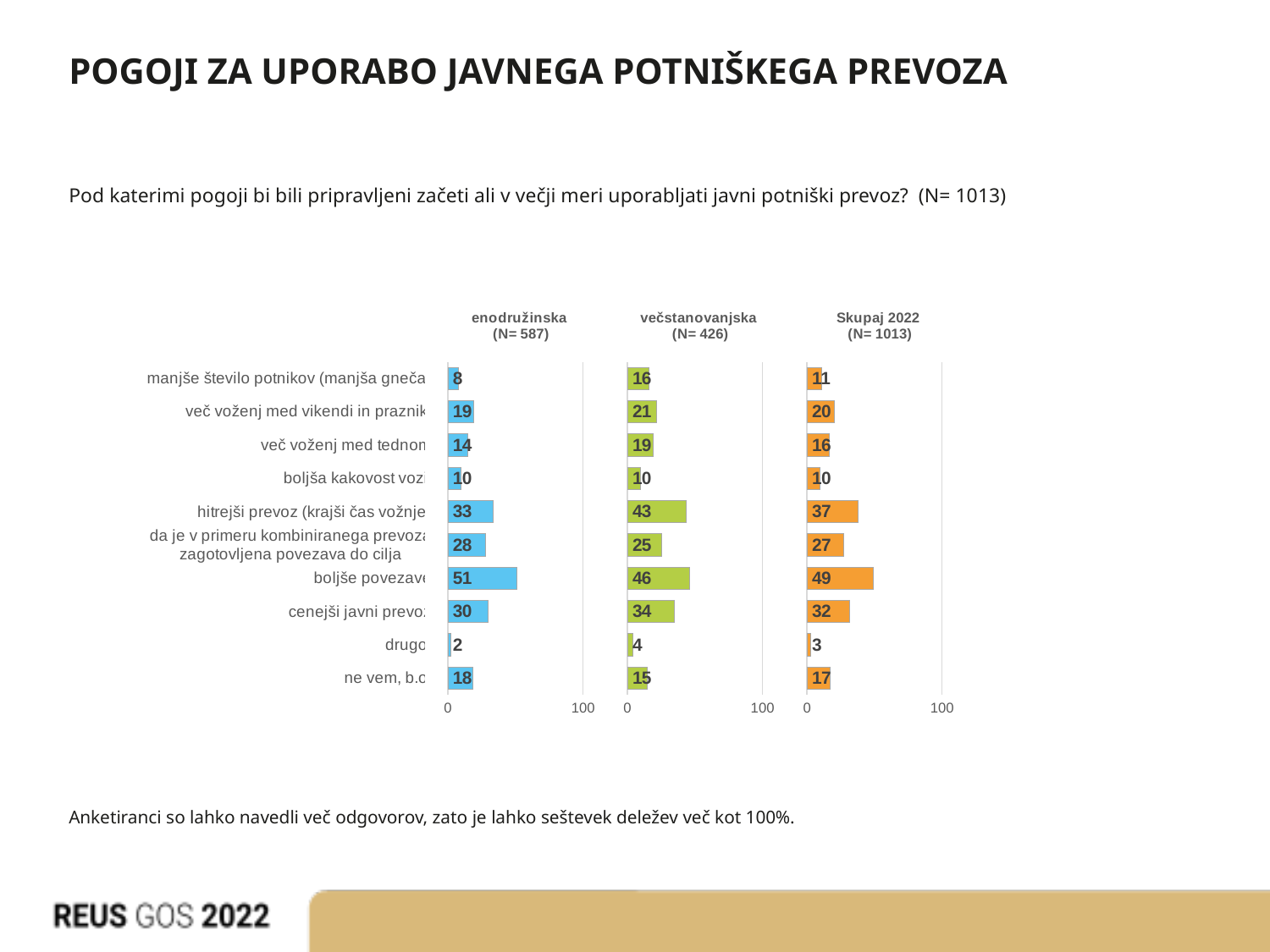
Which is larger: 'hitrejši prevoz (krajši čas vožnje)' in the 'enodružinska (N= 587)' chart or in the 'večstanovanjska (N= 426)' chart? večstanovanjska (N= 426) In the 'večstanovanjska (N= 426)' chart, what is the difference between 'boljše povezave' and 'hitrejši prevoz (krajši čas vožnje)'? 3 What colour are the bars in the 'Skupaj 2022 (N= 1013)' chart? orange In the 'enodružinska (N= 587)' chart, is the value for 'boljše povezave' greater or less than 100? less In the 'Skupaj 2022 (N= 1013)' chart, what is the value for 'hitrejši prevoz (krajši čas vožnje)'? 37 How many categories are shown in the 'Skupaj 2022 (N= 1013)' chart? 10 In the 'enodružinska (N= 587)' chart, what is the value for 'cenejši javni prevoz'? 30 What kind of chart is the 'večstanovanjska (N= 426)' chart? bar chart In the 'Skupaj 2022 (N= 1013)' chart, what is the difference between 'cenejši javni prevoz' and 'ne vem, b.o.'? 15 In the 'enodružinska (N= 587)' chart, which category has the highest value? boljše povezave In the 'večstanovanjska (N= 426)' chart, what is the value for 'več voženj med tednom'? 19 In the 'Skupaj 2022 (N= 1013)' chart, which category has the lowest value? drugo